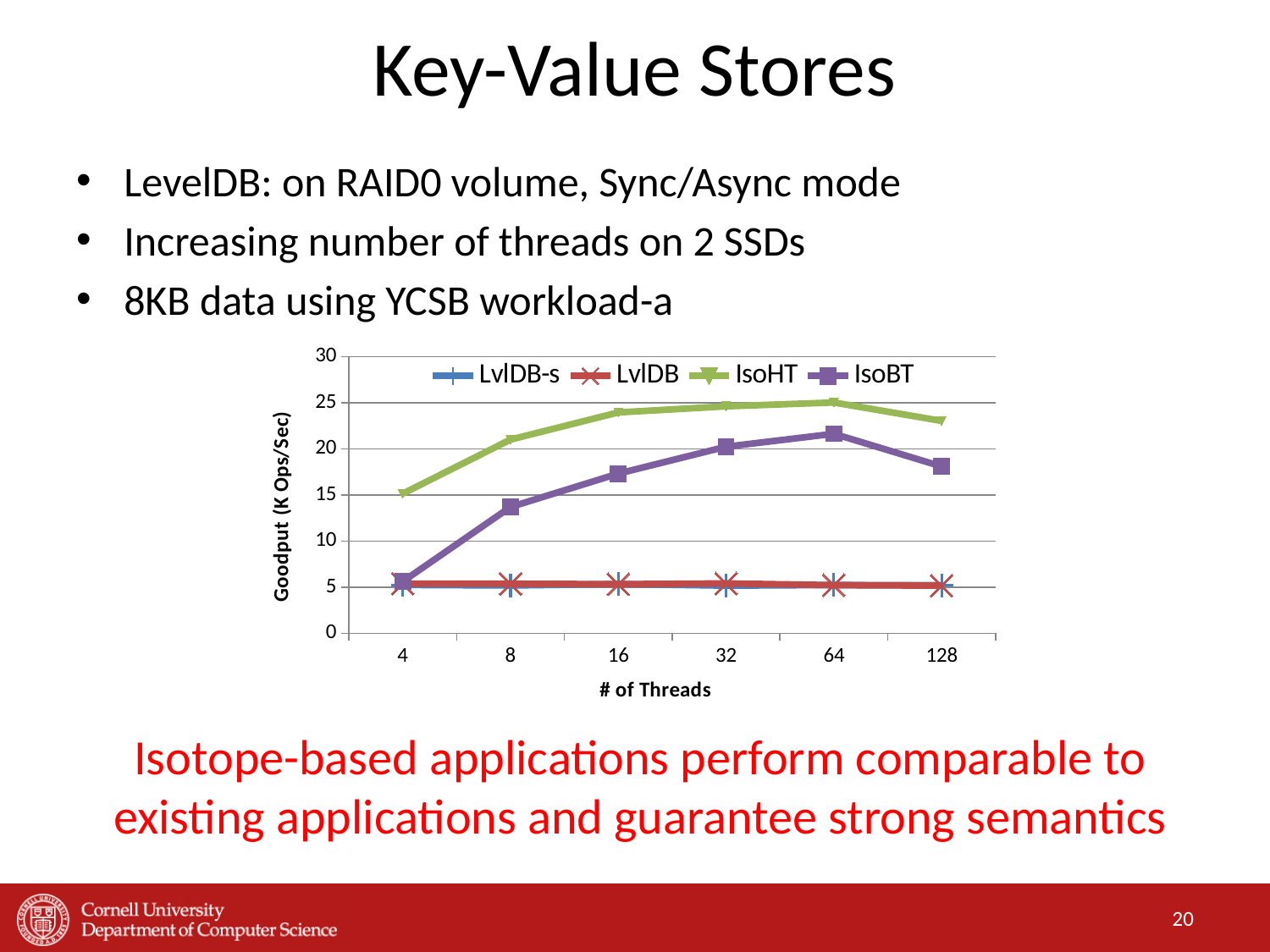
Is the goodput for IsoBT at 4 threads greater or less than 10? less Which series has the highest goodput at 64 threads? IsoHT Is the goodput for IsoBT at 128 threads greater or less than 15? greater What kind of chart is shown on the slide? line chart How many series does the chart's legend list? 4 How many thread-count values are plotted along the x axis? 6 Does the goodput for IsoBT rise or fall as the number of threads increases from 4 to 64? rise What is the title of the chart's y axis? Goodput (K Ops/Sec) Is the goodput for LvlDB at 8 threads greater or less than 10? less At 32 threads, which has the higher goodput, IsoHT or IsoBT? IsoHT